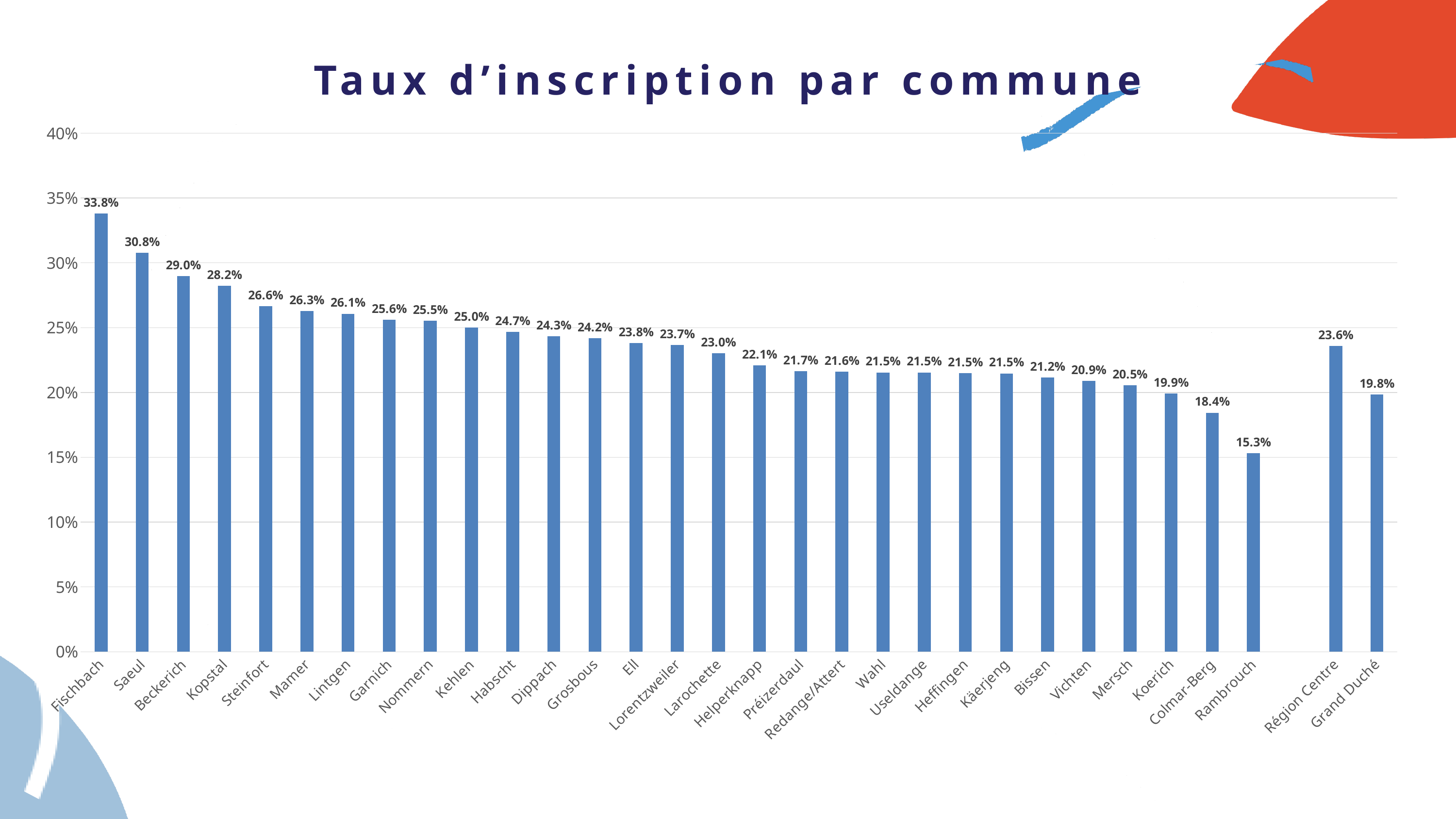
Which commune has the highest rate? Fischbach What is the title of the chart? Taux d’inscription par commune Is the value for Colmar-Berg greater or less than 20%? less What is the value for Région Centre? 23.6% Which category has the lowest value? Rambrouch What is the difference between the values for Fischbach and Saeul? 3.0% What is the value for Fischbach? 33.8% What is the value for Rambrouch? 15.3% What kind of chart is shown on the slide? bar chart Which is larger, the value for Mersch or the value for Koerich? Mersch What is the value for Grand Duché? 19.8% How many bars are shown in the chart? 31